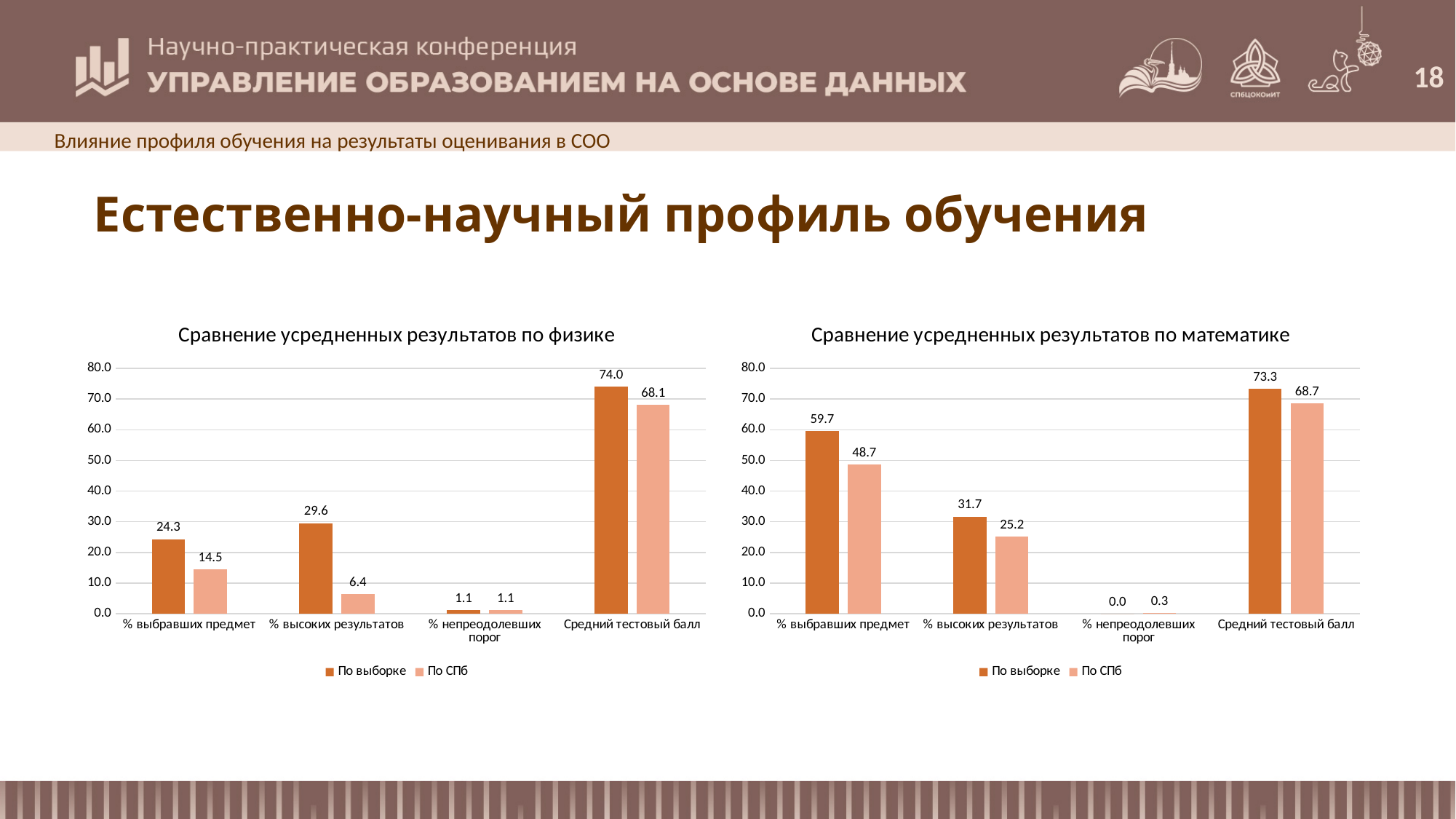
How many categories are shown on the x axis of the chart 'Сравнение усредненных результатов по математике'? 4 In the chart 'Сравнение усредненных результатов по математике', which category has the lowest value for 'По СПб'? % непреодолевших порог In the chart 'Сравнение усредненных результатов по математике', what is the difference between 'По выборке' and 'По СПб' for '% выбравших предмет'? 11.0 In the chart 'Сравнение усредненных результатов по физике', what is the value of 'По выборке' for '% выбравших предмет'? 24.3 What type of chart is 'Сравнение усредненных результатов по математике'? Bar chart How many series does the legend of the chart 'Сравнение усредненных результатов по физике' list? 2 In the chart 'Сравнение усредненных результатов по физике', which category has the highest value for 'По выборке'? Средний тестовый балл In the chart 'Сравнение усредненных результатов по математике', what is the value of 'По выборке' for 'Средний тестовый балл'? 73.3 In the chart 'Сравнение усредненных результатов по математике', what is the value of 'По СПб' for '% непреодолевших порог'? 0.3 In the chart 'Сравнение усредненных результатов по физике', what is the difference between 'По выборке' and 'По СПб' for 'Средний тестовый балл'? 5.9 In the chart 'Сравнение усредненных результатов по физике', what is the value of 'По СПб' for '% высоких результатов'? 6.4 In the chart 'Сравнение усредненных результатов по физике', which is larger for '% высоких результатов': 'По выборке' or 'По СПб'? По выборке